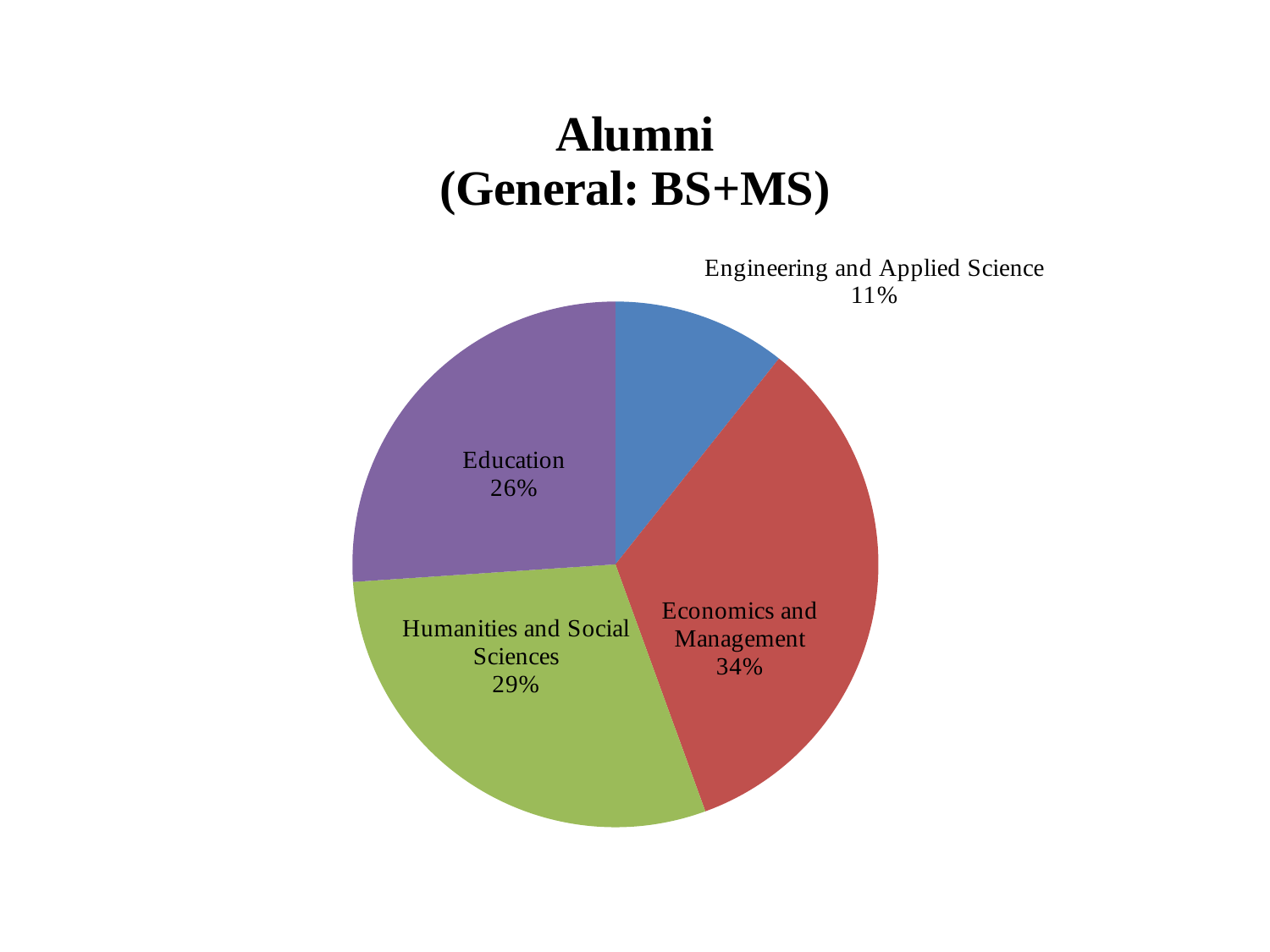
What colour is the Economics and Management slice? Red What kind of chart is shown on the slide? Pie chart What share of the pie does Education have? 26% Which is larger, the share for Humanities and Social Sciences or the share for Education? Humanities and Social Sciences What share of the pie does Economics and Management have? 34% Which category has the smallest share of the pie? Engineering and Applied Science Which category has the largest share of the pie? Economics and Management What is the title of the chart? Alumni (General: BS+MS) What share of the pie does Engineering and Applied Science have? 11% How many slices does the pie chart have? 4 What is the difference in percentage points between Economics and Management and Education? 8